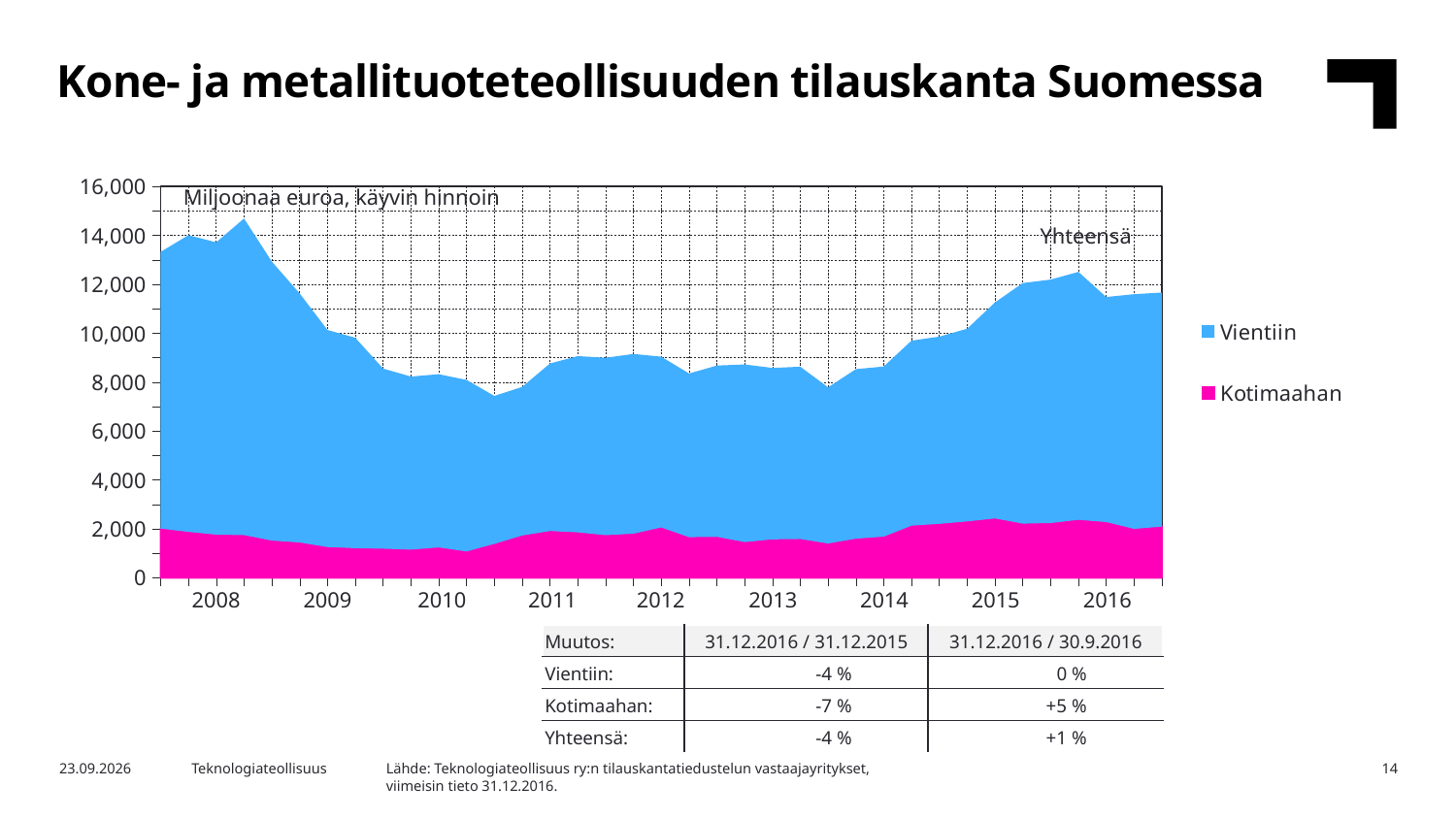
How many series does the chart legend list? 2 Is the total value at the start of 2010 greater or less than 10,000? less Is the total value at the peak in 2008 greater or less than 14,000? greater In which year does the total (Yhteensä) reach its highest point? 2008 What type of chart is shown on the slide? Stacked area chart Is the total value at the end of 2016 greater or less than 10,000? greater Does the total order backlog rise or fall between 2008 and 2010? fall What unit label is printed inside the chart area? Miljoonaa euroa, käyvin hinnoin Which series, Vientiin or Kotimaahan, has the larger values throughout the chart? Vientiin What are the two series named in the chart legend? Vientiin and Kotimaahan How many year labels are shown on the x axis? 9